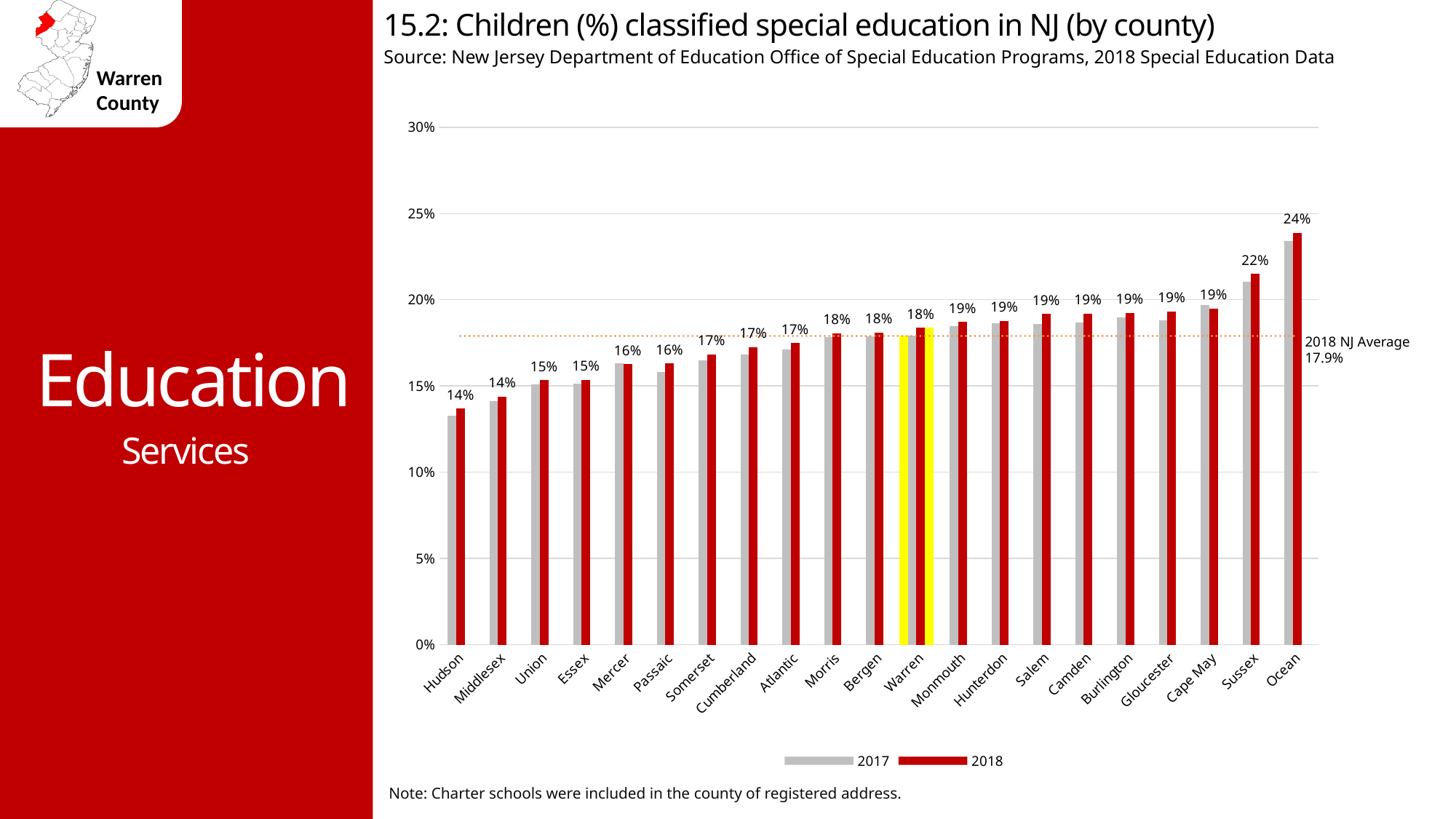
What is the 2018 value for Ocean County? 24% What kind of chart is shown? Bar chart What is the 2018 NJ average shown by the dotted line? 17.9% Which county has the highest 2018 value? Ocean Is the 2017 value for Hudson County greater or less than 15%? less How many series does the legend list? 2 What is the 2018 value for Hudson County? 14% How many counties are shown on the x axis? 21 What is the difference between the 2018 values for Ocean and Hudson counties? 10 percentage points Which county has the larger 2018 value, Sussex or Mercer? Sussex What is the 2018 value for Sussex County? 22% What is the 2018 value for Warren County? 18%